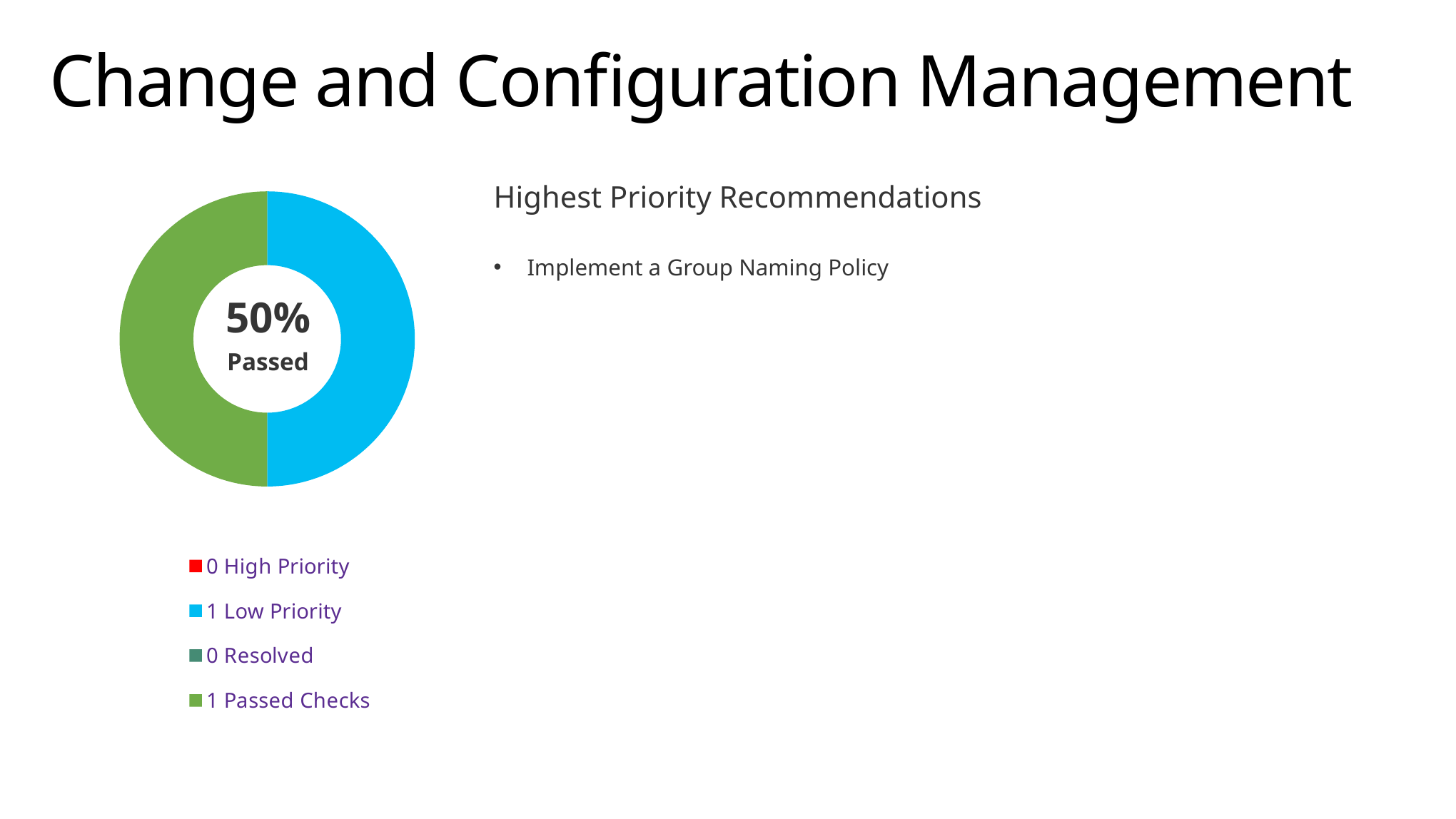
How many Low Priority items does the legend show? 1 How many Passed Checks does the legend show? 1 Is the count for Low Priority larger or smaller than the count for High Priority? Larger How many High Priority items does the legend show? 0 What share of the doughnut chart does the Passed Checks slice take up? 50% Which colour represents Low Priority in the doughnut chart? Blue How many entries does the legend of the doughnut chart list? 4 What word appears below the percentage in the centre of the doughnut chart? Passed What is the total of all the counts listed in the legend? 2 How many Resolved items does the legend show? 0 What kind of chart is shown on the slide? Doughnut chart What percentage is shown in the centre of the doughnut chart? 50%